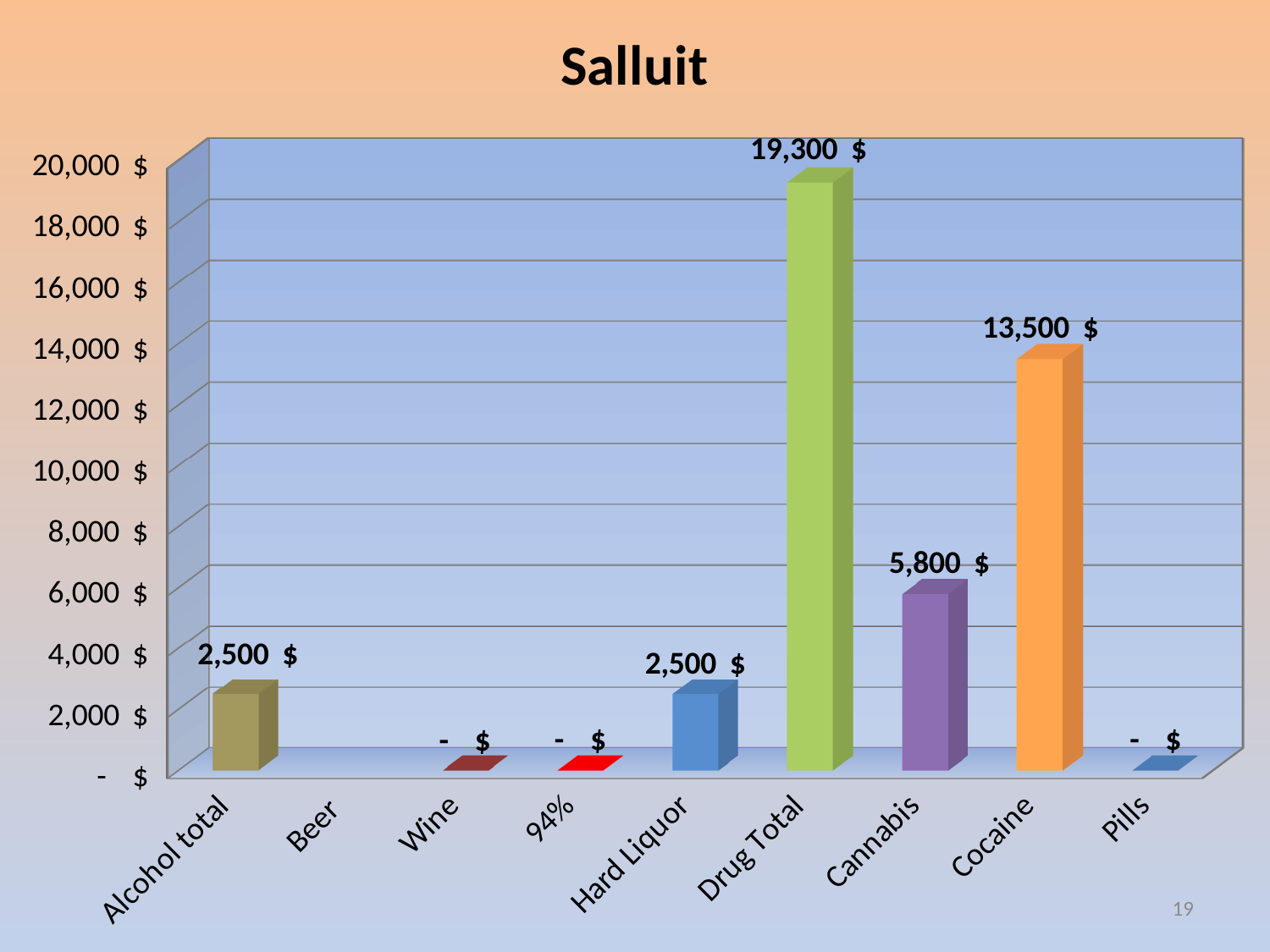
What is the value for Alcohol total? 2,500 $ What is the value for Drug Total? 19,300 $ What kind of chart is shown on the slide? Bar chart What is the difference between the values for Cocaine and Cannabis? 7,700 $ Which category has the highest value? Drug Total What is the value for Hard Liquor? 2,500 $ What is the difference between the values for Drug Total and Cocaine? 5,800 $ How many categories are shown on the x axis? 9 What is the value for Cannabis? 5,800 $ Which is larger, the value for Cocaine or the value for Cannabis? Cocaine Is the value for Cannabis greater or less than 4,000 $? greater What is the value for Cocaine? 13,500 $